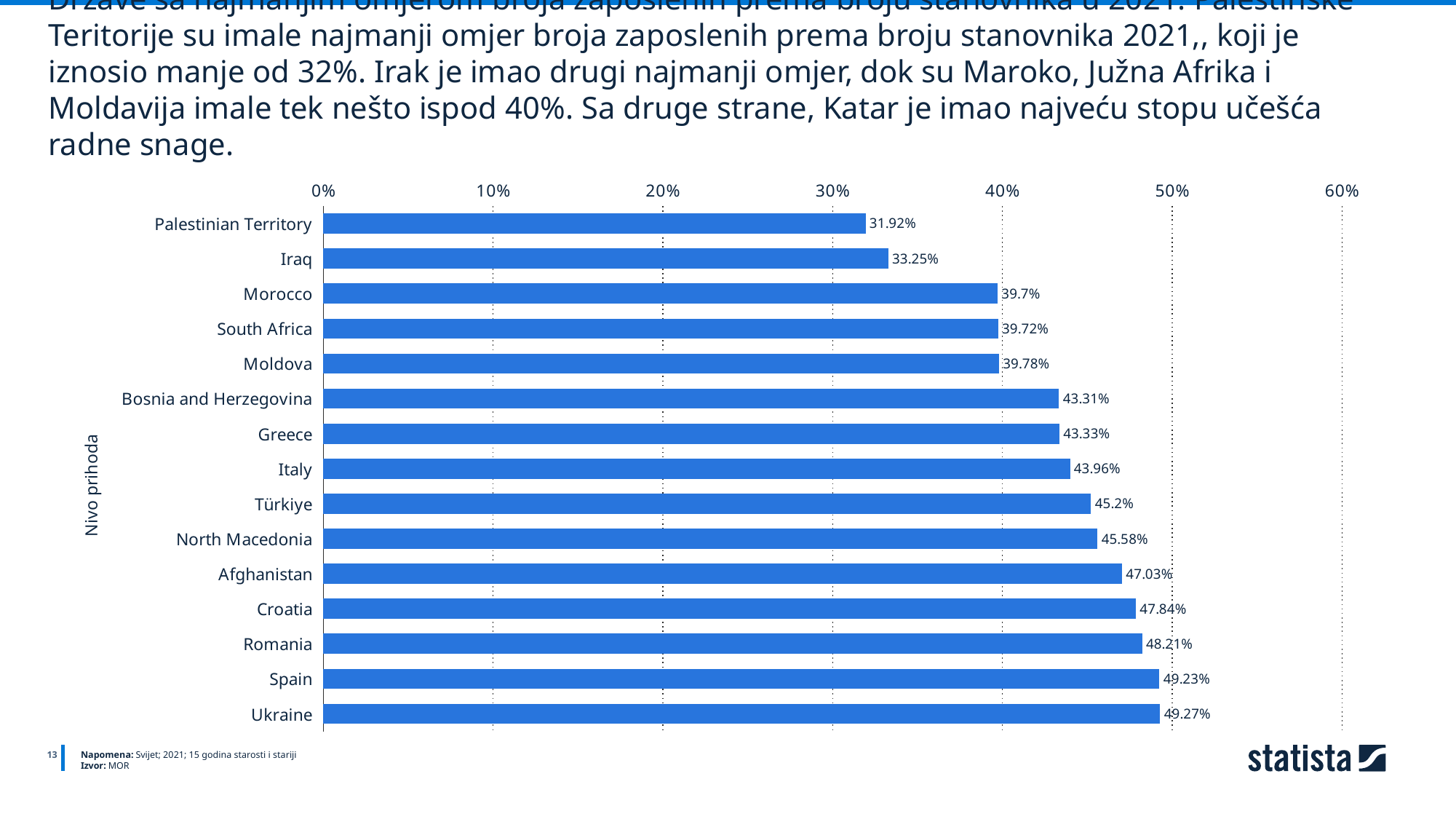
What kind of chart is shown on the slide? bar chart What is the difference between the values for Italy and Greece? 0.63 percentage points What is the value for Türkiye? 45.2% What is the value for Croatia? 47.84% Which country has the lowest value on the chart? Palestinian Territory What is the label on the vertical axis of the chart? Nivo prihoda What is the difference between the values for Iraq and Palestinian Territory? 1.33 percentage points Which is larger, the value for Afghanistan or the value for Italy? Afghanistan Which country has the highest value on the chart? Ukraine How many countries are shown on the chart? 15 Is the value for Iraq greater or less than 40%? less What is the value for Palestinian Territory? 31.92%